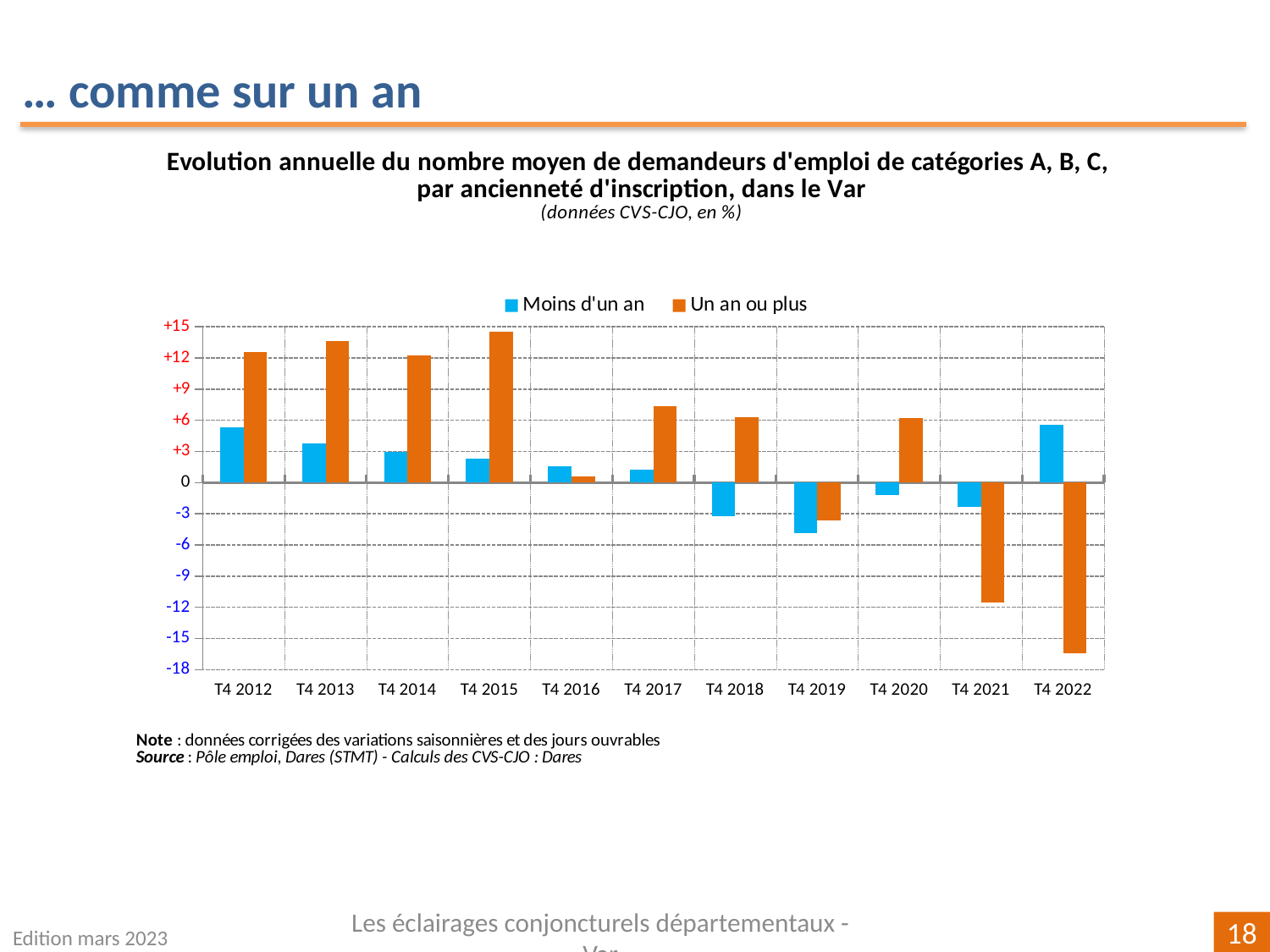
Which quarter has the lowest value for the 'Moins d'un an' series? T4 2019 How many quarters (categories) are shown on the x axis? 11 Is the value for 'Un an ou plus' in T4 2012 greater or less than 9? greater In T4 2018, which series has the larger value, 'Moins d'un an' or 'Un an ou plus'? Un an ou plus Which quarter has the highest value for the 'Un an ou plus' series? T4 2015 In T4 2022, which series has the larger value, 'Moins d'un an' or 'Un an ou plus'? Moins d'un an Is the value for 'Un an ou plus' in T4 2021 greater or less than -9? less Is the value for 'Un an ou plus' in T4 2022 greater or less than -15? less Which quarter has the lowest value for the 'Un an ou plus' series? T4 2022 How many series does the legend list? 2 What kind of chart is shown on the slide? bar chart What colour are the bars for the 'Un an ou plus' series? orange